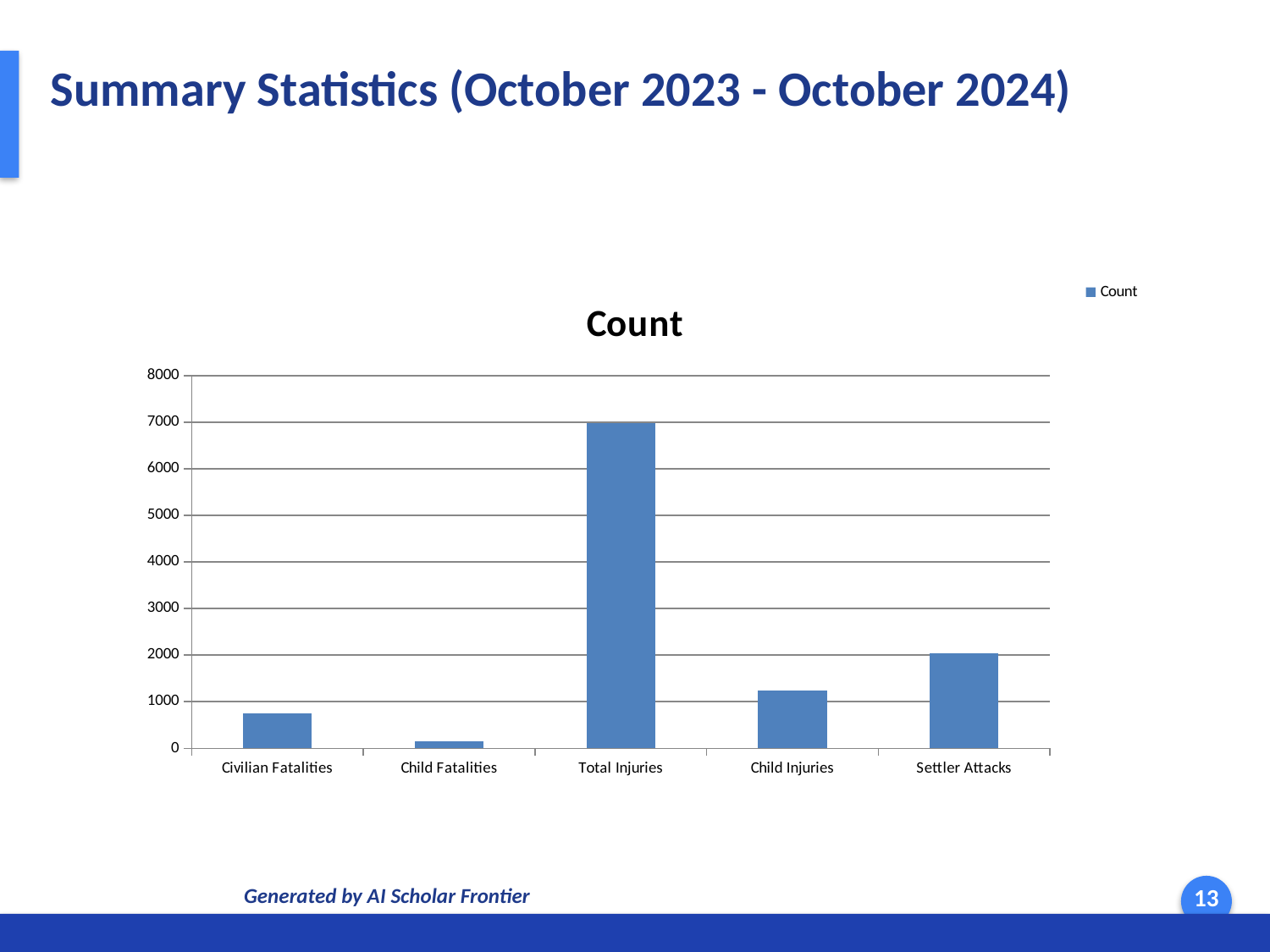
Which category has the lowest value? Child Fatalities Which is larger, the value for Civilian Fatalities or the value for Child Fatalities? Civilian Fatalities How many series does the legend list? 1 How many categories are shown on the x axis of the chart? 5 Is the value for Total Injuries greater or less than 6000? greater What kind of chart is shown on the slide? bar chart Is the value for Settler Attacks greater or less than 1000? greater Which is larger, the value for Settler Attacks or the value for Child Injuries? Settler Attacks Is the value for Child Injuries greater or less than 2000? less Which category has the highest value? Total Injuries What is the title of the chart? Count